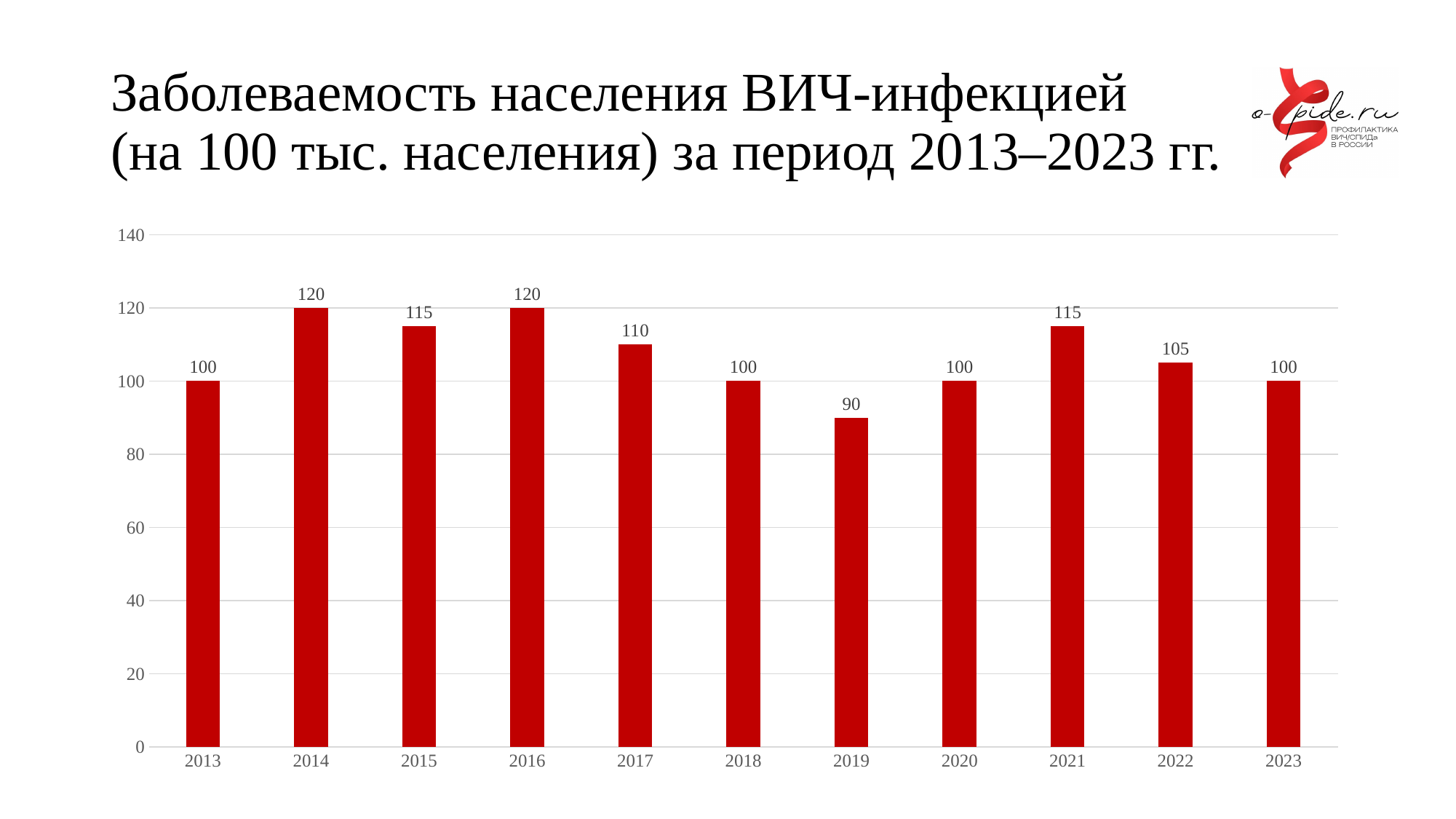
Which is larger, the value for 2015 or the value for 2018? 2015 Do the values rise or fall from 2016 to 2019? fall What colour are the bars in the chart? red Which year has the lowest value? 2019 Is the value for 2014 greater or less than 100? greater What kind of chart is shown on the slide? bar chart What is the value for 2019? 90 How many years are shown on the x axis? 11 What is the value for 2017? 110 What is the difference between the values for 2021 and 2022? 10 What is the difference between the values for 2016 and 2019? 30 What is the value for 2022? 105